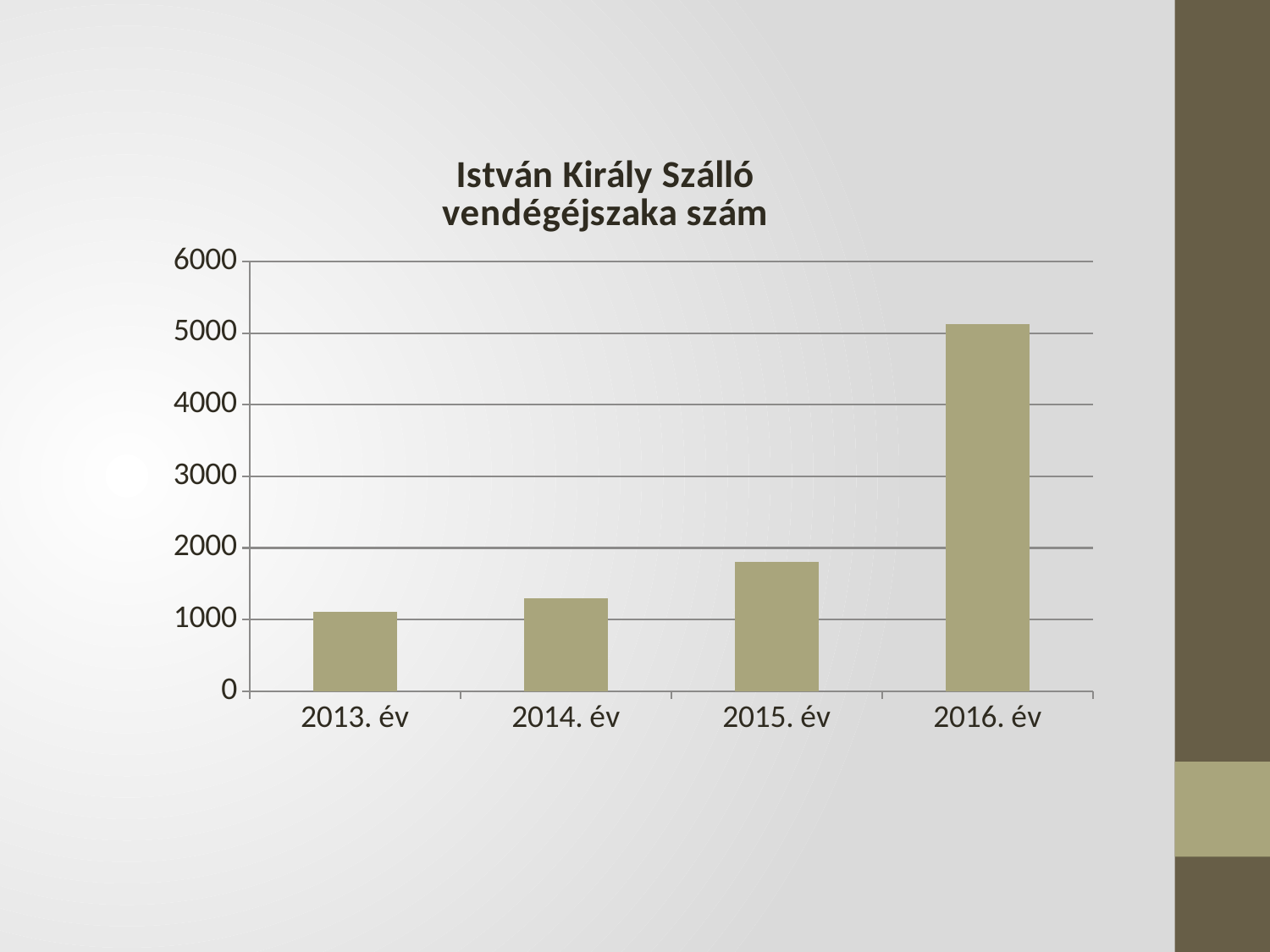
What is the title of the chart? István Király Szálló vendégéjszaka szám Which year has the lowest number of guest nights? 2013. év Is the value for 2015. év greater or less than 2000? less Is the value for 2013. év greater or less than 2000? less Is the value for 2014. év greater or less than 1000? greater Which is larger, the value for 2016. év or the value for 2015. év? 2016. év Which year has the highest number of guest nights? 2016. év Which is larger, the value for 2015. év or the value for 2014. év? 2015. év How many years are shown on the x axis of the chart? 4 What kind of chart is shown on the slide? bar chart Do the values rise or fall from 2013. év to 2016. év? rise